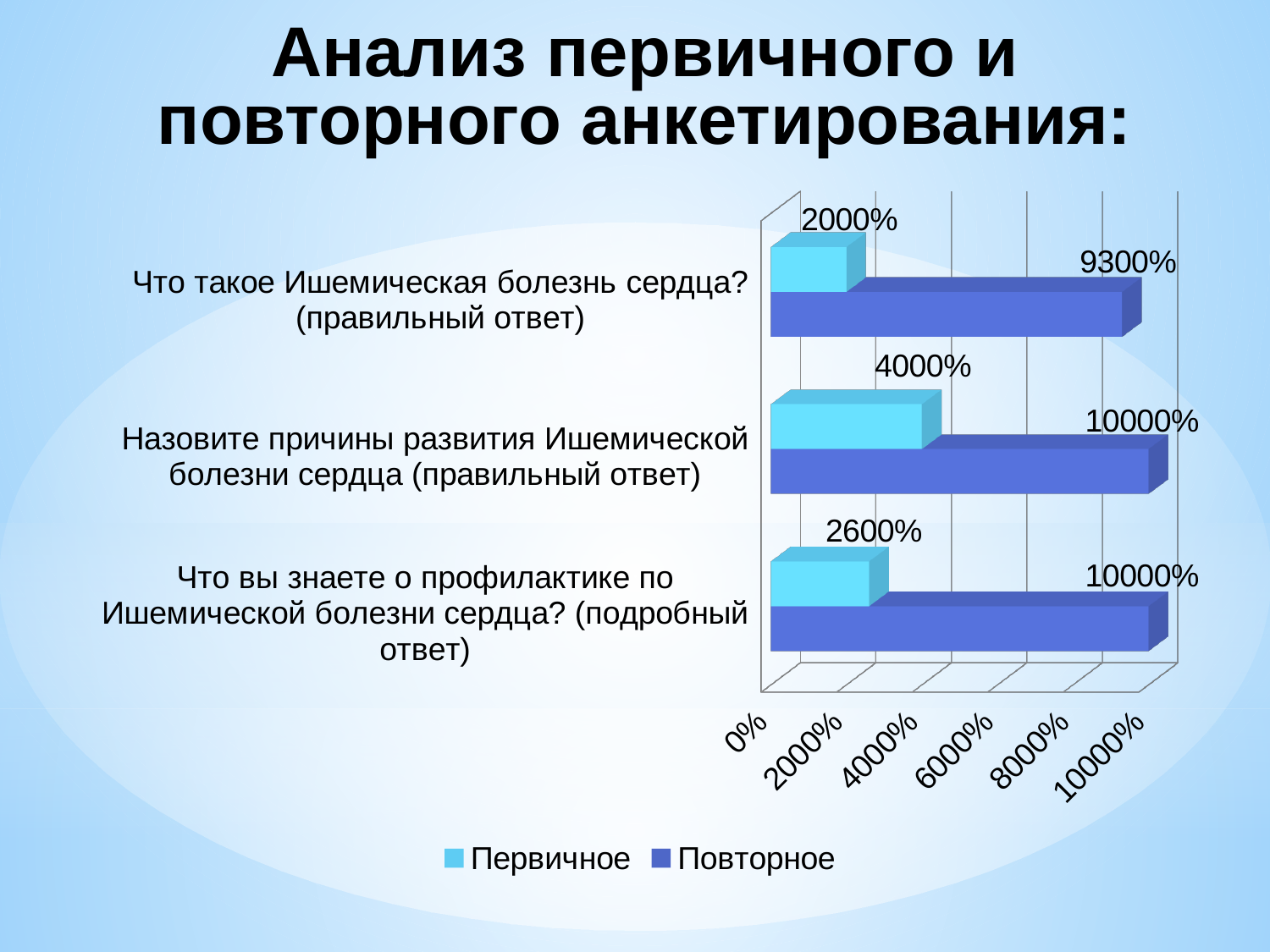
What is the difference between the "Повторное" and "Первичное" values for "Что вы знаете о профилактике по Ишемической болезни сердца? (подробный ответ)"? 7400% What is the difference between the "Повторное" and "Первичное" values for "Что такое Ишемическая болезнь сердца? (правильный ответ)"? 7300% What is the value of the "Повторное" series for "Что такое Ишемическая болезнь сердца? (правильный ответ)"? 9300% How many series does the legend list? 2 Which category has the lowest value in the "Повторное" series? Что такое Ишемическая болезнь сердца? (правильный ответ) Which is larger for "Назовите причины развития Ишемической болезни сердца (правильный ответ)": the "Первичное" value or the "Повторное" value? Повторное What is the value of the "Повторное" series for "Что вы знаете о профилактике по Ишемической болезни сердца? (подробный ответ)"? 10000% What is the value of the "Первичное" series for "Что такое Ишемическая болезнь сердца? (правильный ответ)"? 2000% What is the value of the "Первичное" series for "Назовите причины развития Ишемической болезни сердца (правильный ответ)"? 4000% Which category has the lowest value in the "Первичное" series? Что такое Ишемическая болезнь сердца? (правильный ответ) How many categories are shown on the chart? 3 Which category has the highest value in the "Первичное" series? Назовите причины развития Ишемической болезни сердца (правильный ответ)